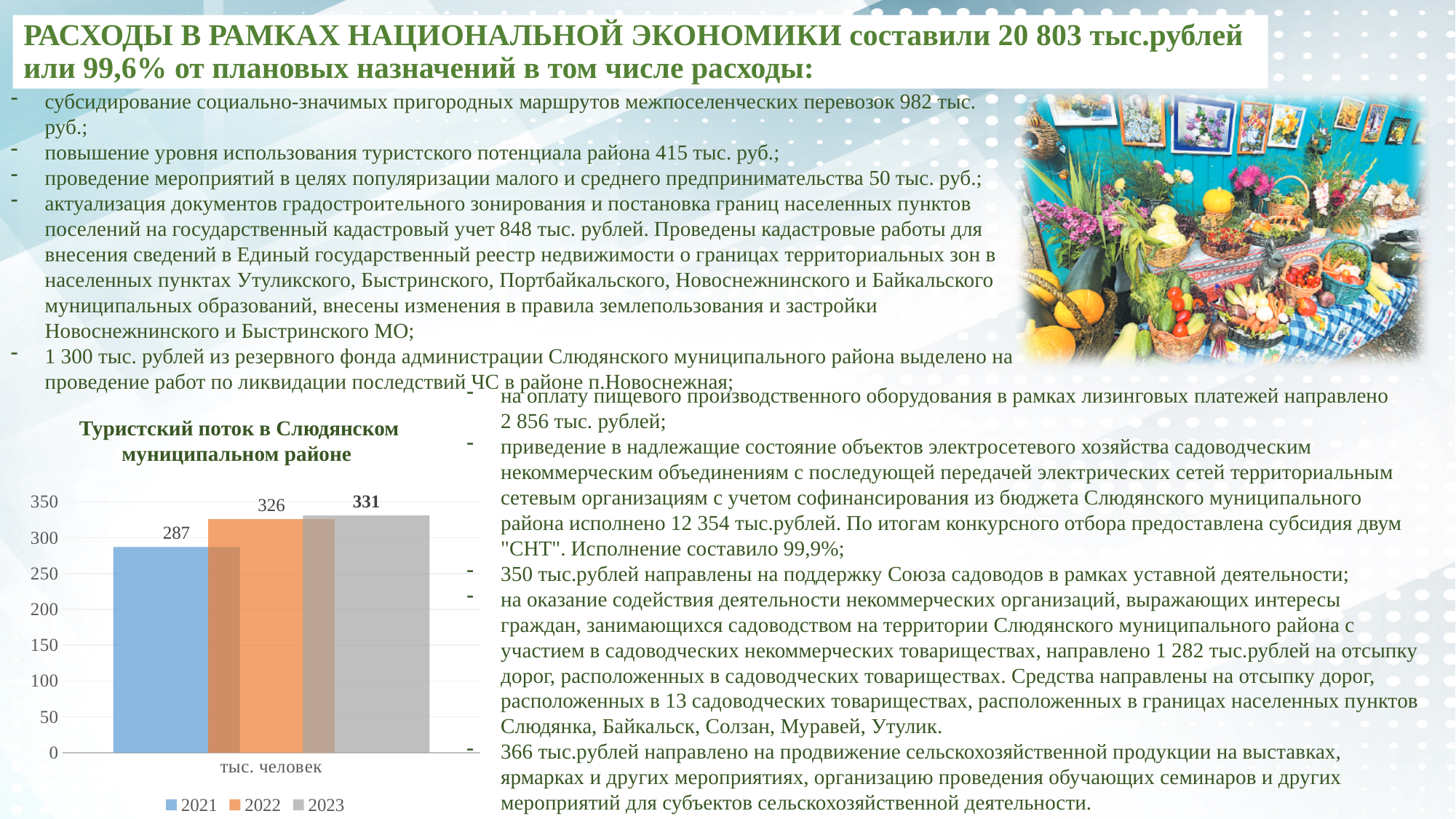
What is the value for 2022 in the chart? 326 What kind of chart is shown on the slide? bar chart What is the difference between the values for 2023 and 2021? 44 What is the value for 2023 in the chart? 331 How many series does the legend list? 3 Is the value for 2021 greater or less than 300? less Which year has the lowest value in the chart? 2021 What is the value for 2021 in the chart 'Туристский поток в Слюдянском муниципальном районе'? 287 What is the difference between the values for 2022 and 2021? 39 Which year has the highest value in the chart? 2023 What is the x-axis category label under the bars? тыс. человек Which is larger, the value for 2021 or the value for 2022? 2022